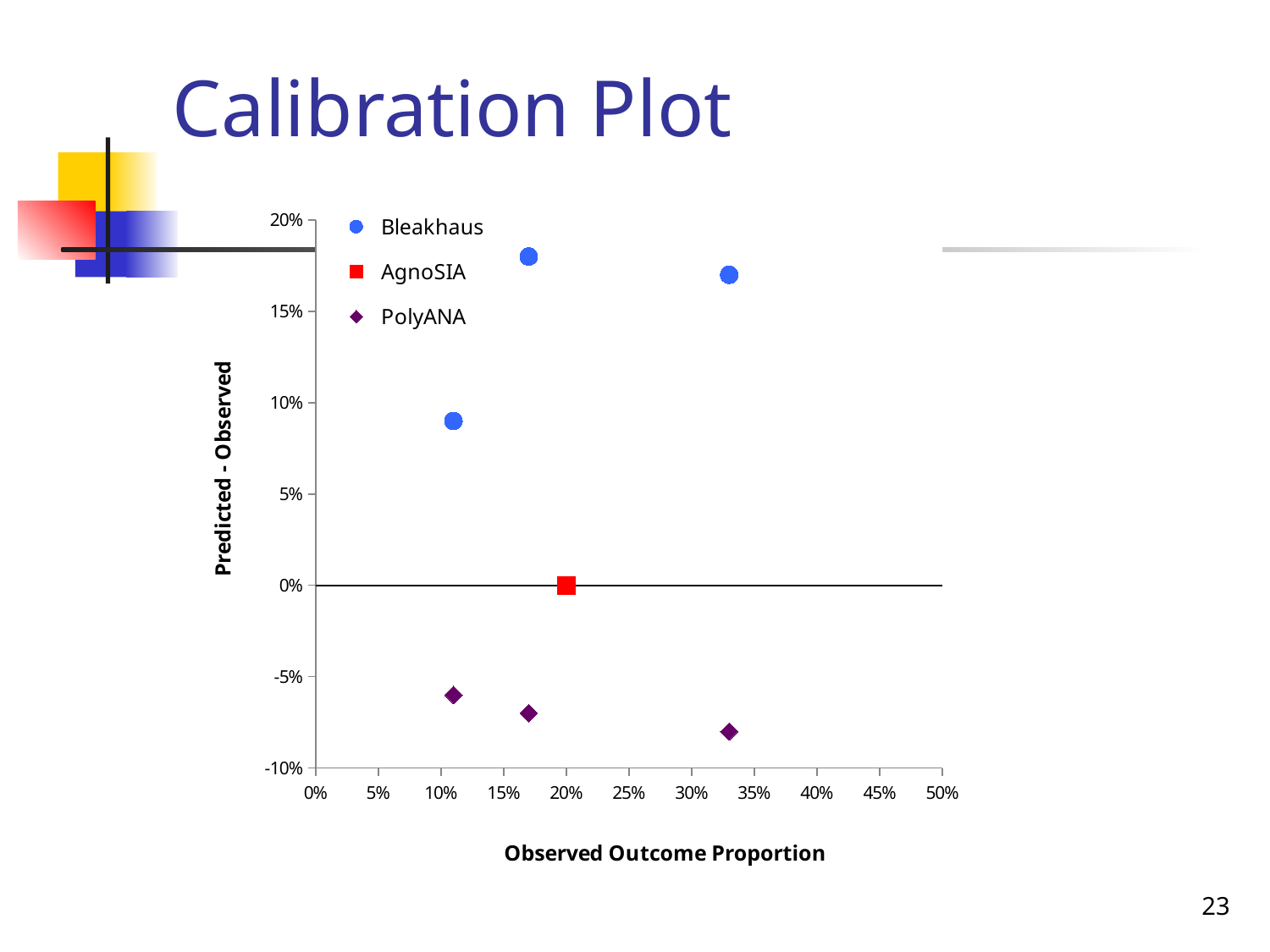
What is the title of the vertical axis? Predicted - Observed How many AgnoSIA points are plotted? 1 How many Bleakhaus points are plotted? 3 What kind of chart is shown on the slide? scatter plot How many PolyANA points are plotted? 3 What is the title of the horizontal axis? Observed Outcome Proportion Are the Predicted - Observed values for the PolyANA points greater or less than 0%? less How many series does the legend list? 3 What is the Predicted - Observed value for the AgnoSIA point? 0% Which series has the highest Predicted - Observed value on the chart? Bleakhaus Are the Predicted - Observed values for the Bleakhaus points greater or less than 5%? greater Which series has the lowest Predicted - Observed value on the chart? PolyANA